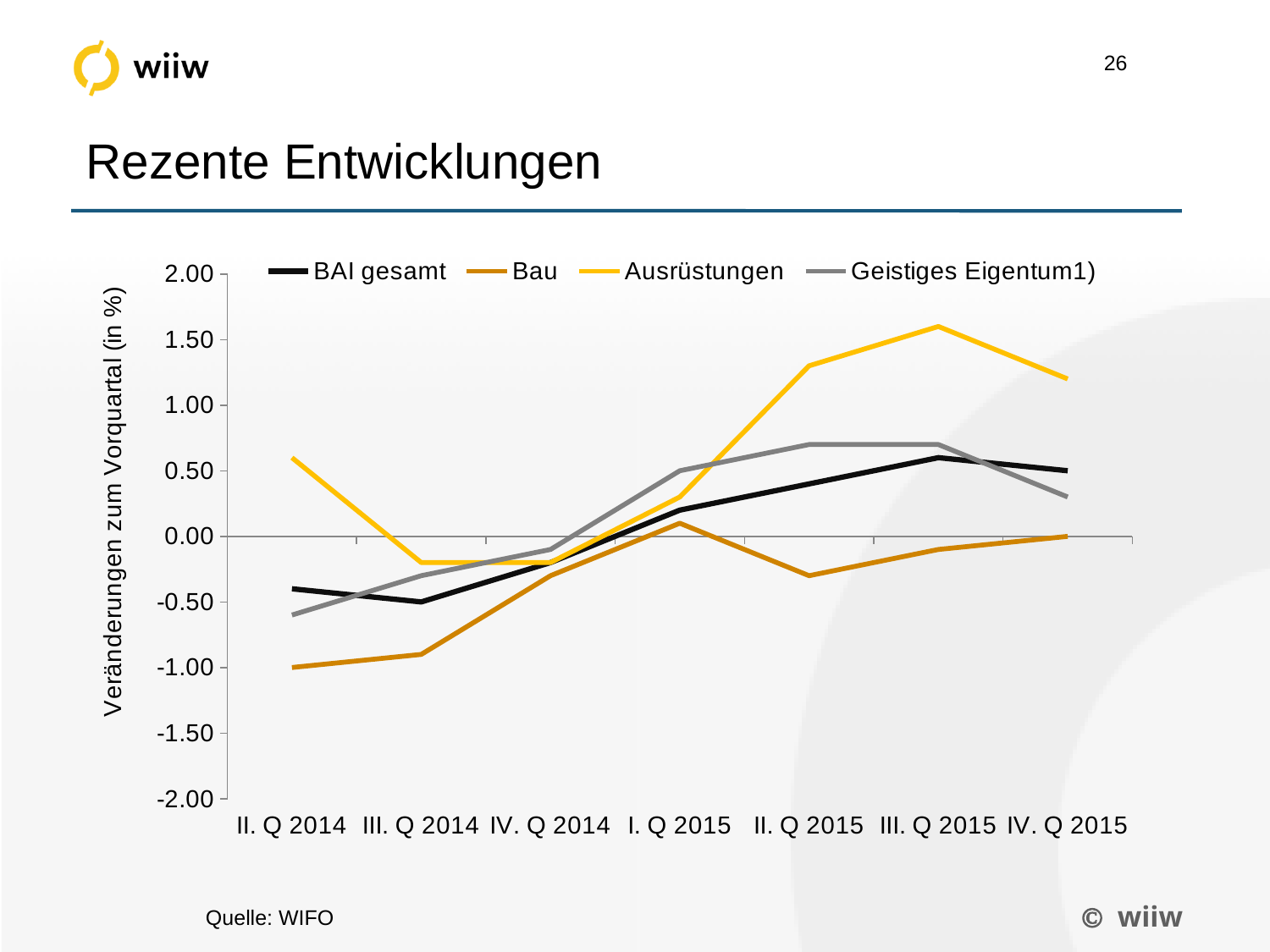
In IV. Q 2015, which is larger: BAI gesamt or Geistiges Eigentum1)? BAI gesamt What is the y-axis title of the chart? Veränderungen zum Vorquartal (in %) How many quarters are shown on the x axis? 7 What is the value for BAI gesamt in III. Q 2014? -0.50 What is the value for Bau in IV. Q 2015? 0.00 Is the value for Ausrüstungen in III. Q 2015 greater or less than 1.50? greater What kind of chart is shown on the slide? line chart Is the value for Bau in II. Q 2015 greater or less than 0.00? less Which series has the highest value in III. Q 2015? Ausrüstungen How many series does the legend list? 4 What is the value for Bau in II. Q 2014? -1.00 Which series has the lowest value in II. Q 2014? Bau